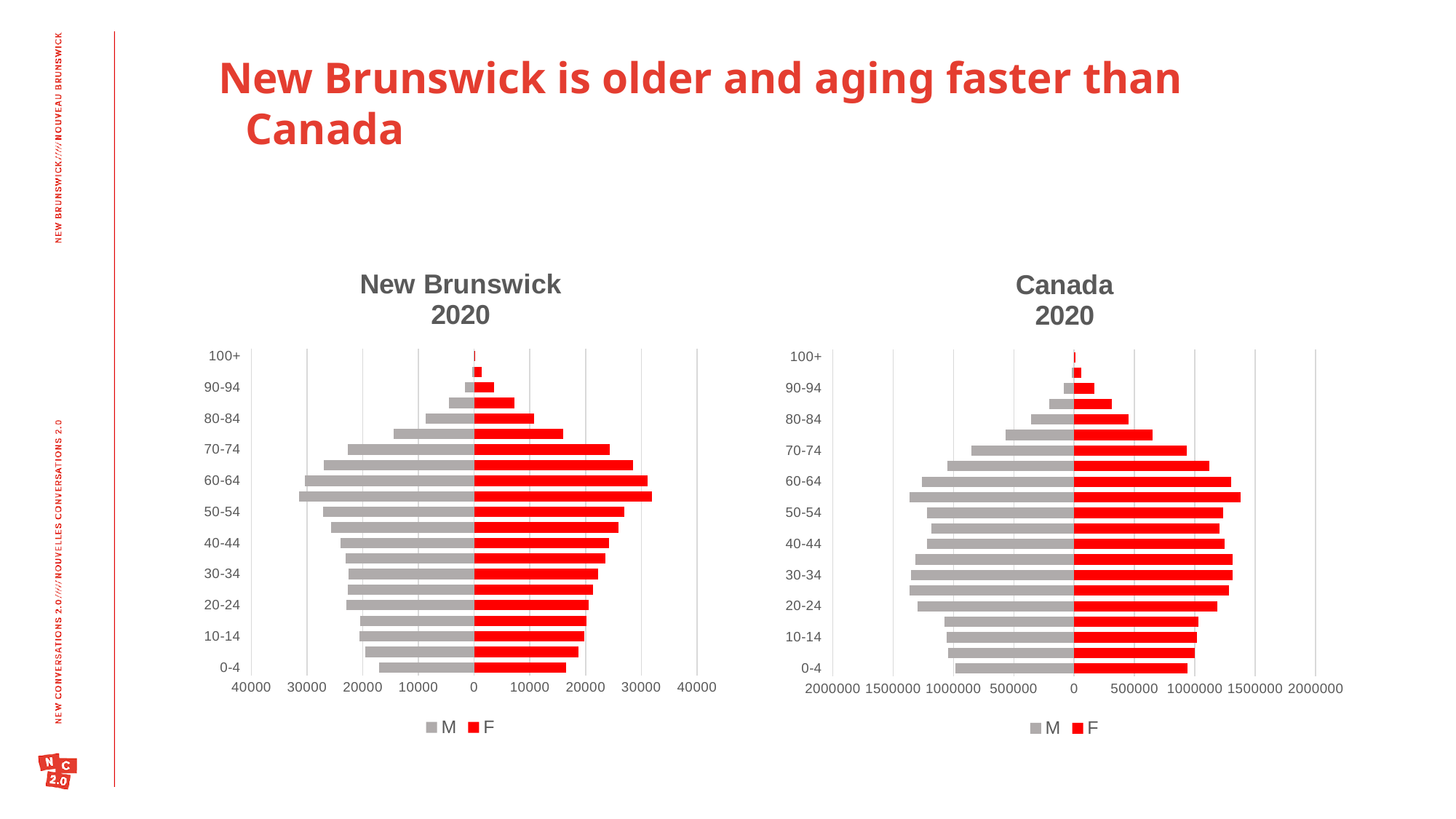
What are the two legend entries in the New Brunswick 2020 chart? M and F What kind of chart is the New Brunswick 2020 chart? bar chart In the Canada 2020 chart, which is larger for the M series: 30-34 or 80-84? 30-34 In the New Brunswick 2020 chart, do the F values rise or fall going from 60-64 up to 100+? fall In the New Brunswick 2020 chart, which is larger for the F series: 60-64 or 0-4? 60-64 How many series does the legend of the Canada 2020 chart list? 2 How many age-group bars are plotted for each series in the Canada 2020 chart? 21 In the Canada 2020 chart, which colour represents the F series? red In the Canada 2020 chart, is the F value for 60-64 greater or less than 1000000? greater In the New Brunswick 2020 chart, is the M value for 70-74 greater or less than 20000? greater In the New Brunswick 2020 chart, is the F value for 0-4 greater or less than 20000? less